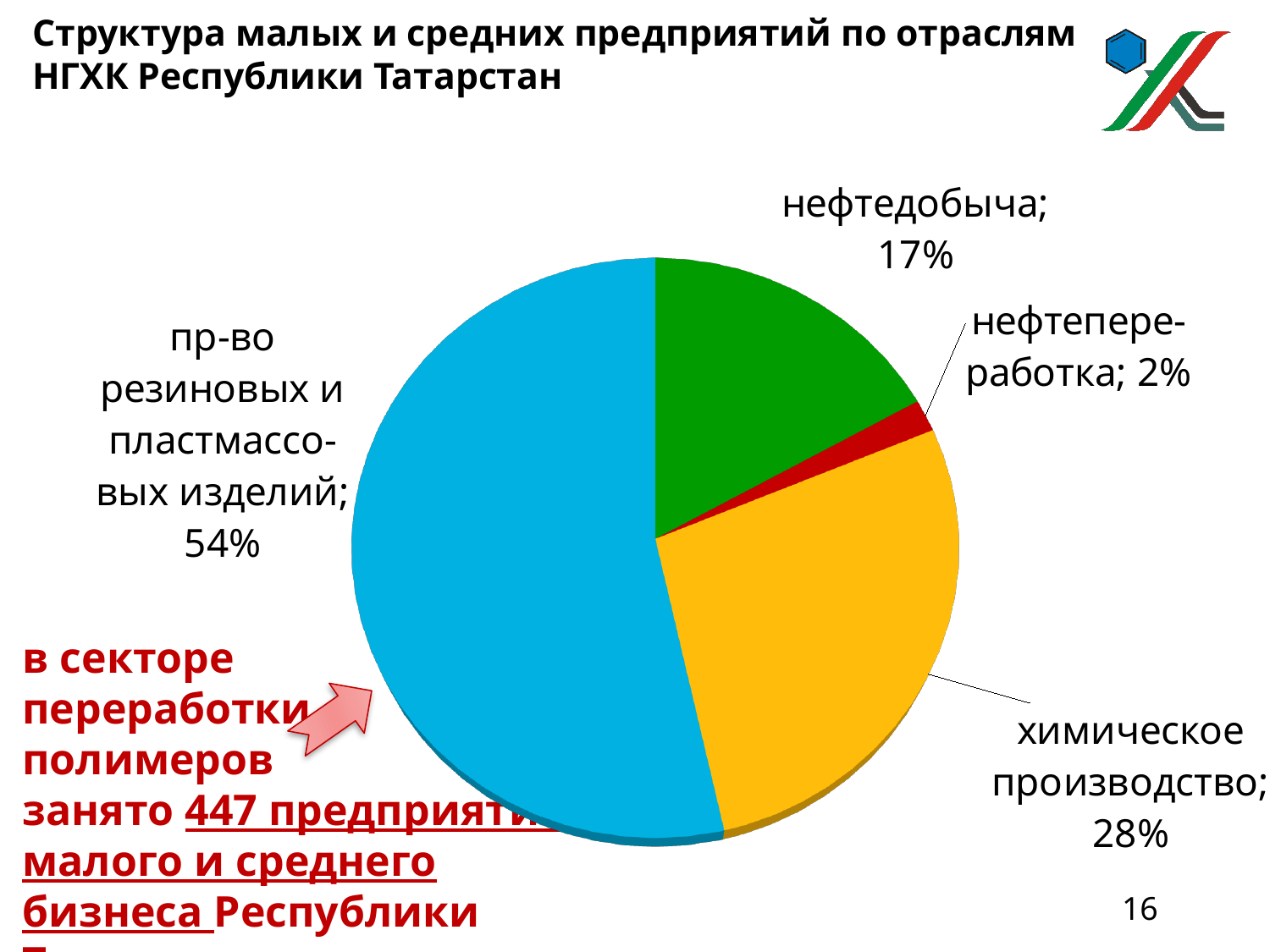
Which sector has the largest slice of the pie? пр-во резиновых и пластмассовых изделий What colour is the slice for химическое производство? yellow What is the difference in percentage points between пр-во резиновых и пластмассовых изделий and химическое производство? 26 What type of chart is shown on the slide? pie chart Which is larger: the share for нефтедобыча or the share for химическое производство? химическое производство How many sectors are shown in the pie chart? 4 What share of the pie does нефтепереработка account for? 2% What share of the pie does нефтедобыча account for? 17% What is the difference in percentage points between химическое производство and нефтедобыча? 11 Which sector has the smallest slice of the pie? нефтепереработка What share of the pie does химическое производство account for? 28% What share of the pie does пр-во резиновых и пластмассовых изделий account for? 54%